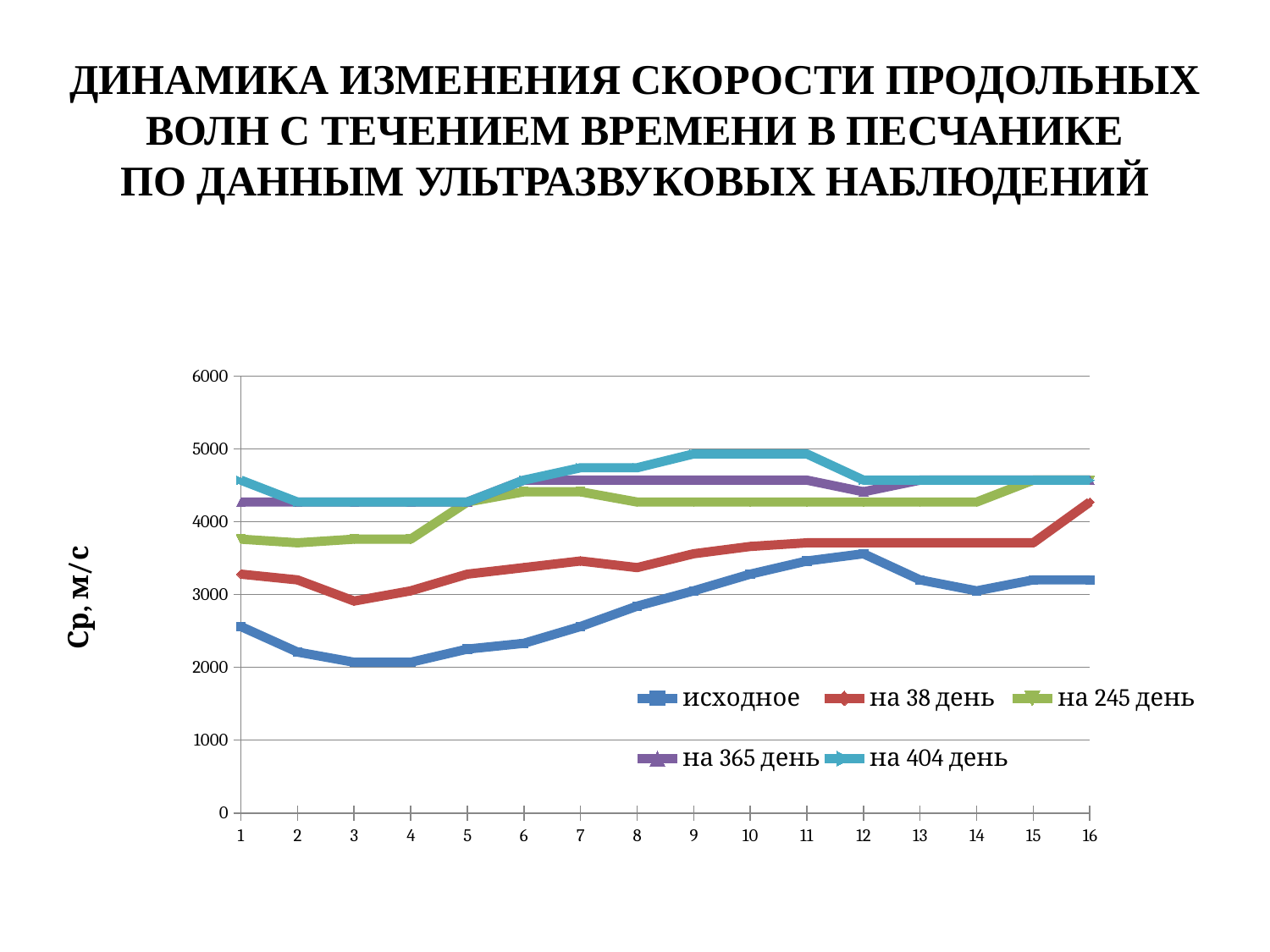
Is the value for "исходное" at point 3 greater or less than 3000? less What type of chart is shown on the slide? line chart At point 1, which is larger: the value for "исходное" or for "на 38 день"? на 38 день At point 10, which series has the highest value? на 404 день What is the label on the y axis? Ср, м/с Is the value for "на 404 день" at point 9 greater or less than 4000? greater How many series does the legend list? 5 How many points are there along the x axis? 16 Is the value for "на 245 день" at point 1 greater or less than 4000? less At which point does the "на 38 день" series reach its highest value? 16 Does the "исходное" series rise or fall from point 4 to point 12? rise